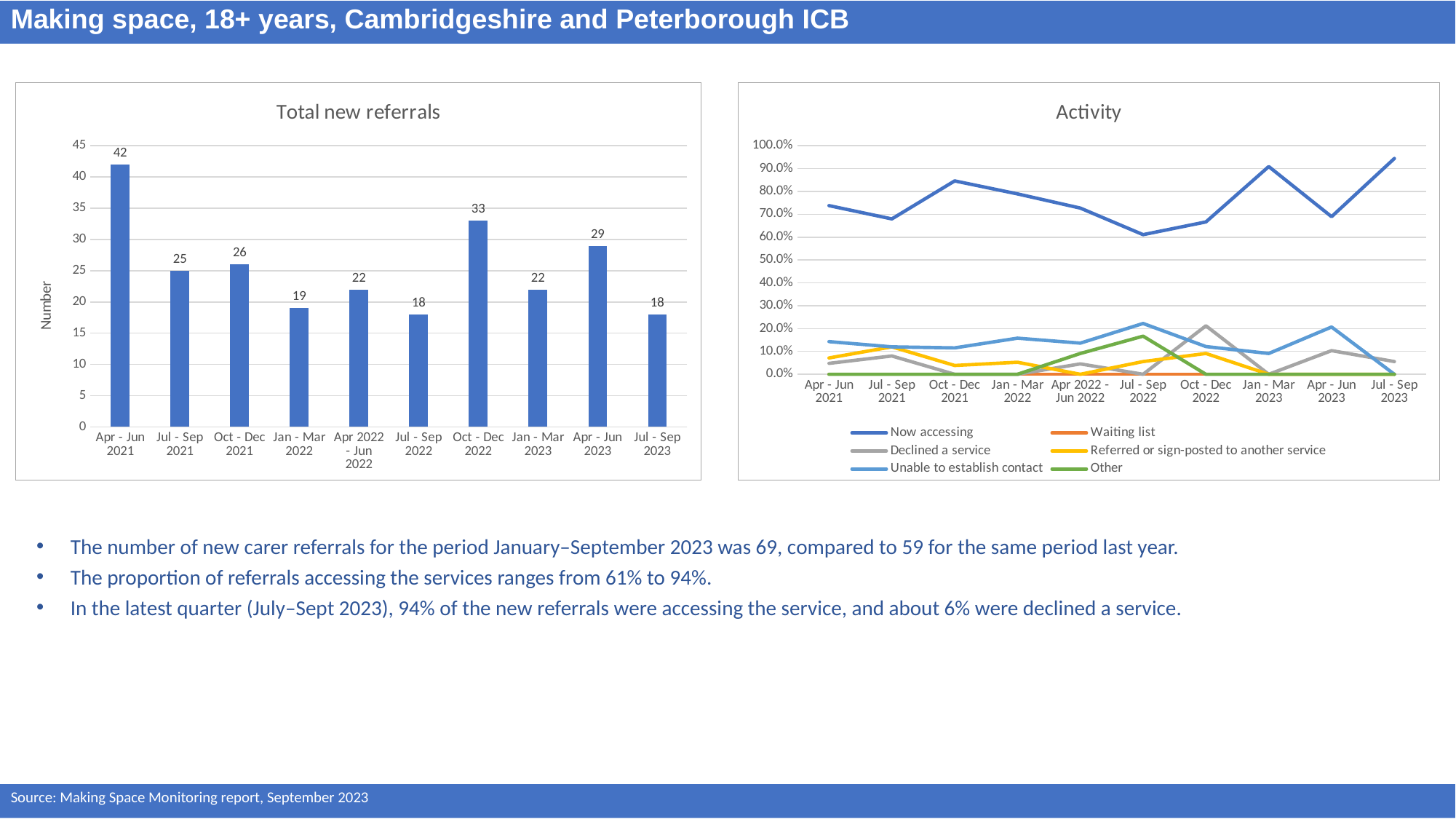
In the 'Activity' chart, which series is shown in green in the legend? Other What kind of chart is the 'Total new referrals' chart? Bar chart In the 'Total new referrals' chart, what is the value for Apr - Jun 2021? 42 In the 'Total new referrals' chart, which is larger: Apr - Jun 2023 or Jan - Mar 2023? Apr - Jun 2023 In the 'Activity' chart, how many series does the legend list? 6 In the 'Total new referrals' chart, what is the value for Oct - Dec 2022? 33 In the 'Activity' chart, is the value for 'Now accessing' in Jul - Sep 2022 greater or less than 70.0%? less In the 'Total new referrals' chart, what is the difference between Apr - Jun 2021 and Jul - Sep 2021? 17 What kind of chart is the 'Activity' chart? Line chart In the 'Total new referrals' chart, how many quarters are shown on the x axis? 10 In the 'Activity' chart, is the value for 'Now accessing' in Jul - Sep 2023 greater or less than 90.0%? greater In the 'Total new referrals' chart, which quarter has the highest number of referrals? Apr - Jun 2021